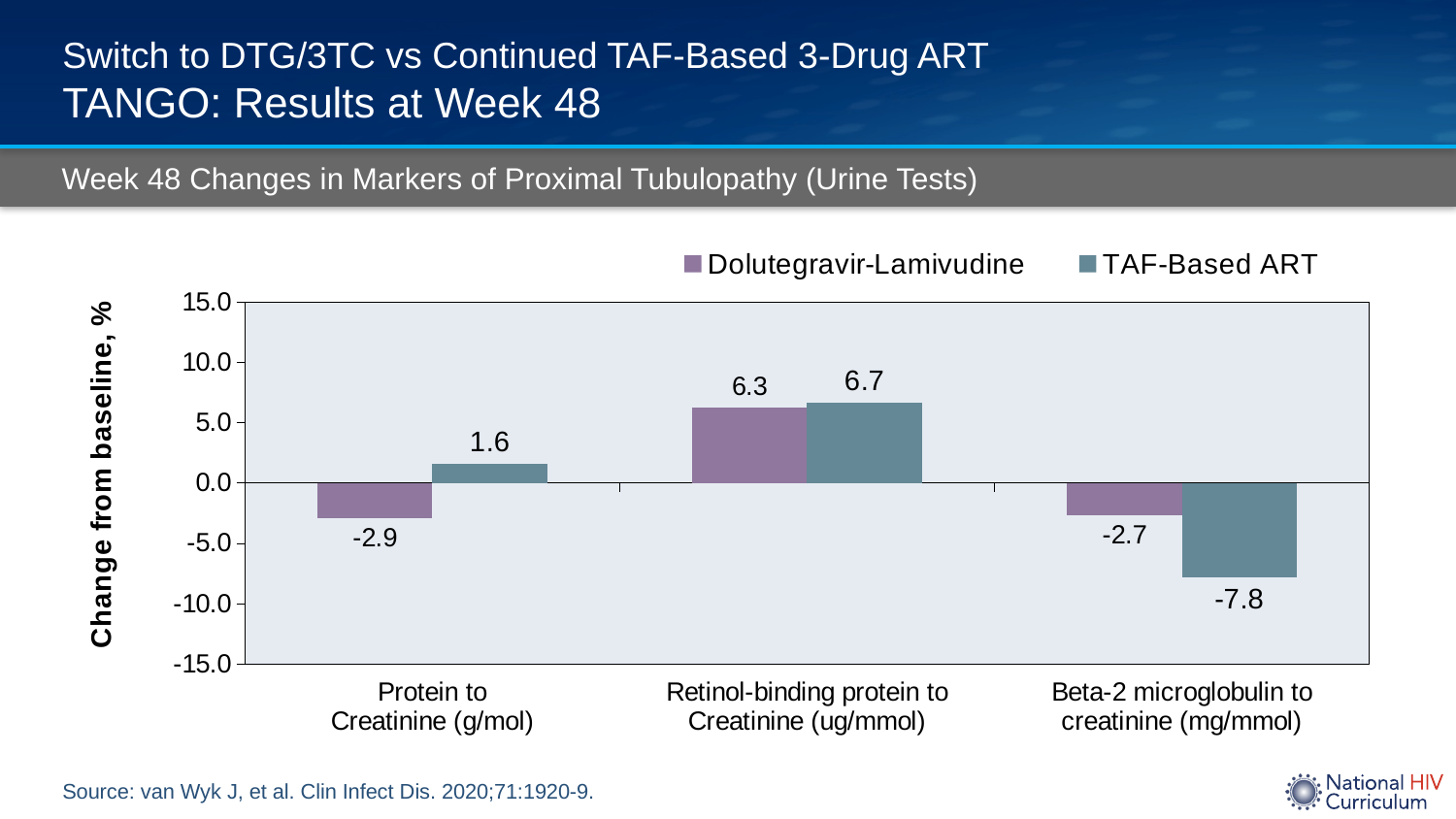
What is the change from baseline for TAF-Based ART in Beta-2 microglobulin to creatinine (mg/mmol)? -7.8 What is the change from baseline for Dolutegravir-Lamivudine in Beta-2 microglobulin to creatinine (mg/mmol)? -2.7 How many series does the legend list? 2 Which category has the highest value for TAF-Based ART? Retinol-binding protein to Creatinine (ug/mmol) What is the difference between the TAF-Based ART and Dolutegravir-Lamivudine values for Protein to Creatinine (g/mol)? 4.5 What kind of chart is shown on the slide? Bar chart Is the TAF-Based ART value for Beta-2 microglobulin to creatinine (mg/mmol) greater or less than -5.0? less What is the change from baseline for Dolutegravir-Lamivudine in Protein to Creatinine (g/mol)? -2.9 Which is larger for Beta-2 microglobulin to creatinine (mg/mmol): the Dolutegravir-Lamivudine value or the TAF-Based ART value? Dolutegravir-Lamivudine Which category has the lowest value for TAF-Based ART? Beta-2 microglobulin to creatinine (mg/mmol) What is the change from baseline for TAF-Based ART in Retinol-binding protein to Creatinine (ug/mmol)? 6.7 How many categories are shown on the x axis? 3